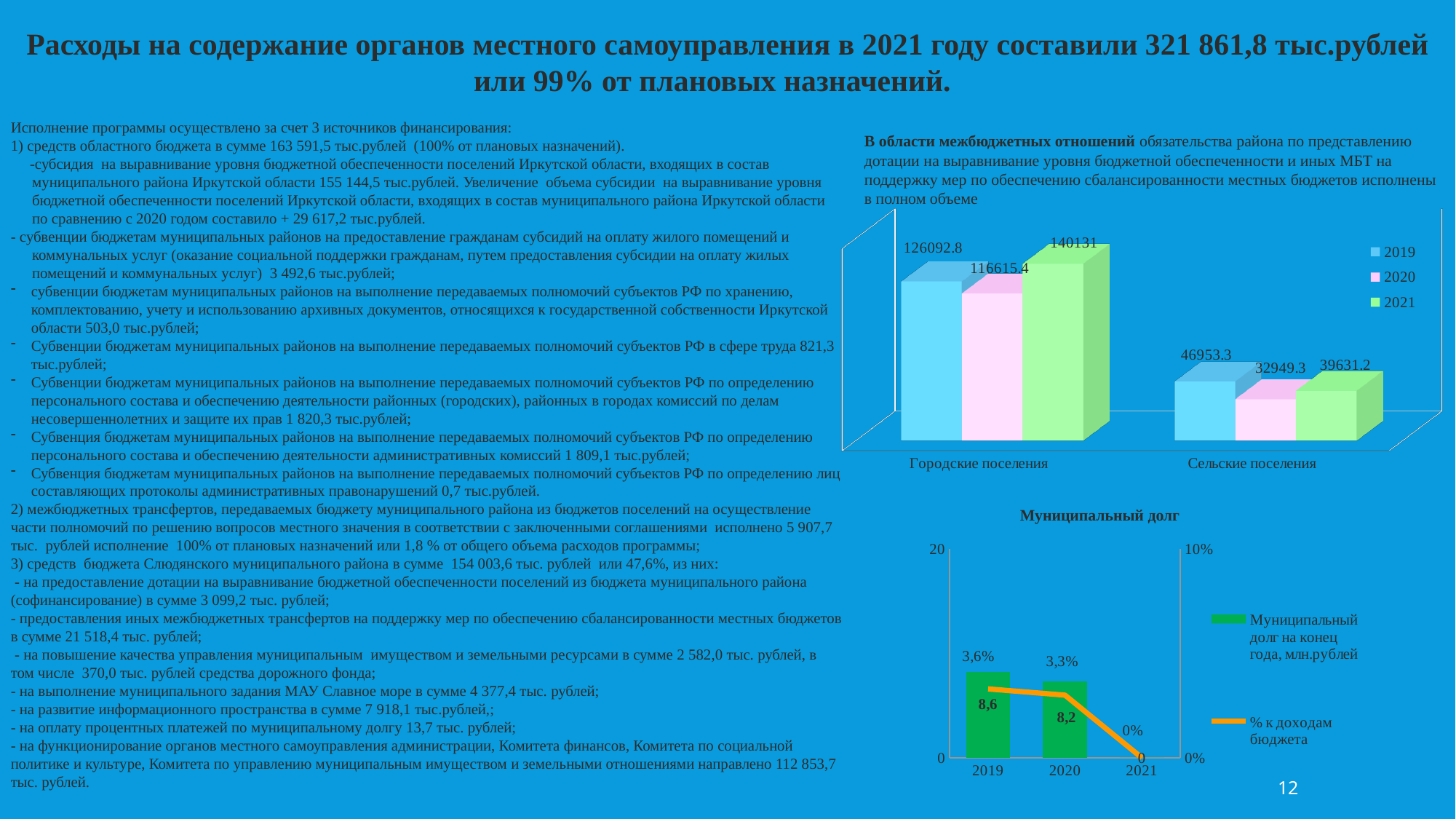
In the top-right bar chart, which is larger for Сельские поселения: the 2019 value or the 2021 value? 2019 In the top-right bar chart, which year has the lowest value for Сельские поселения? 2020 In the top-right bar chart, what is the value for Сельские поселения in 2020? 32949.3 In the top-right bar chart, which year has the highest value for Городские поселения? 2021 In the Муниципальный долг chart, does the % к доходам бюджета line rise or fall from 2019 to 2021? fall How many years are shown on the x axis of the Муниципальный долг chart? 3 How many series does the legend of the top-right bar chart list? 3 What type of chart is the top-right chart on the slide? bar chart In the Муниципальный долг chart, what is the % к доходам бюджета value for 2020? 3,3% In the Муниципальный долг chart, what is the municipal debt at the end of 2019 in million rubles? 8,6 In the top-right bar chart, what is the value for Городские поселения in 2021? 140131 In the top-right bar chart, what is the difference between the 2021 and 2020 values for Городские поселения? 23515.6